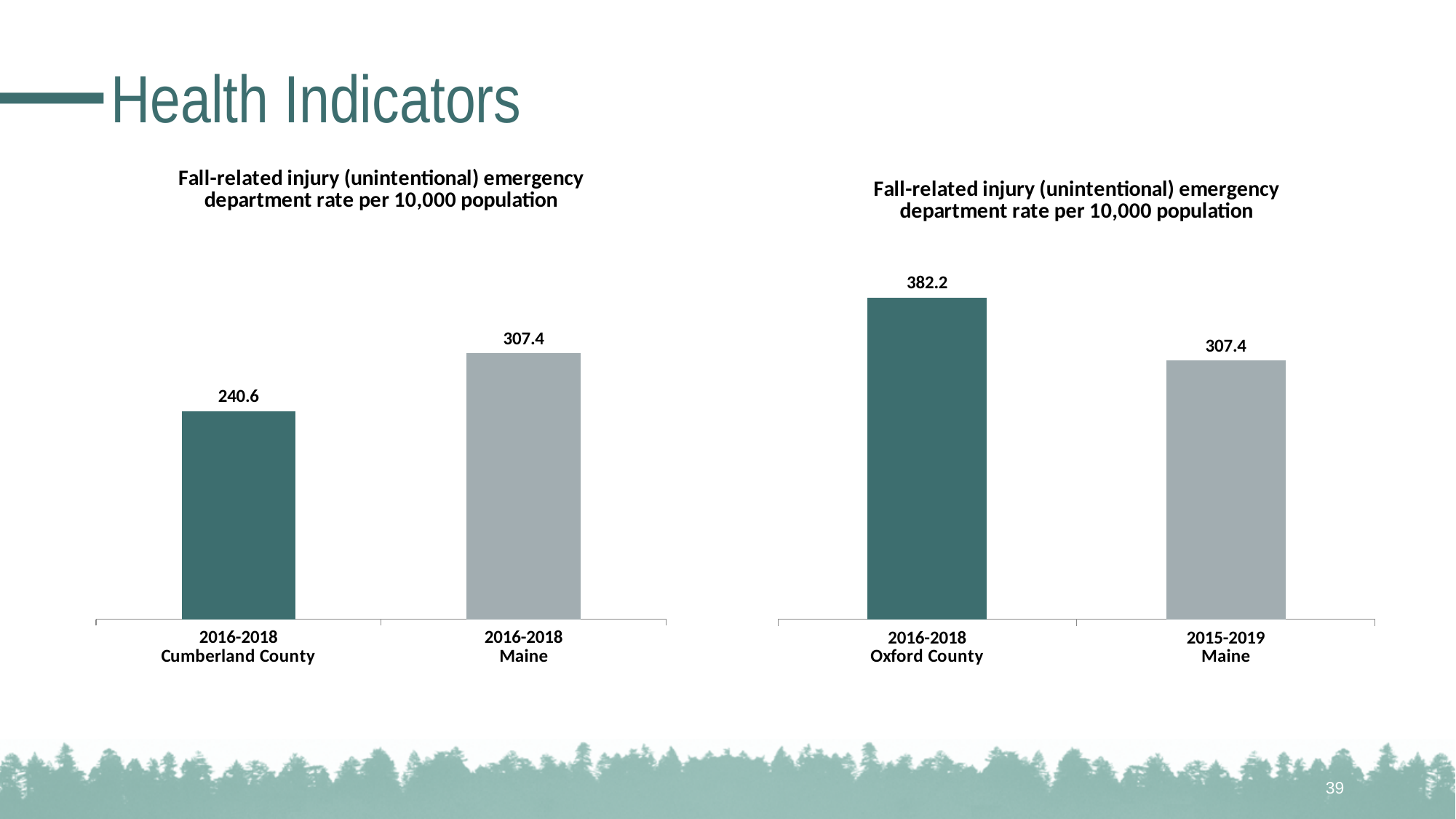
What is the title of the left chart? Fall-related injury (unintentional) emergency department rate per 10,000 population In the right chart, how much higher is the Oxford County rate than the Maine rate? 74.8 In the right chart, which category has the lower value? 2015-2019 Maine In the right chart, is the value for Oxford County larger or smaller than the value for Maine? larger In the left chart, what is the fall-related injury emergency department rate for 2016-2018 Cumberland County? 240.6 In the left chart, what is the value for 2016-2018 Maine? 307.4 In the right chart, what is the fall-related injury emergency department rate for 2016-2018 Oxford County? 382.2 In the left chart, which category has the higher value? 2016-2018 Maine In the right chart, what is the value for 2015-2019 Maine? 307.4 What type of chart is the right chart? bar chart How many bars are shown in the left chart? 2 In the left chart, what is the difference between the Maine value and the Cumberland County value? 66.8